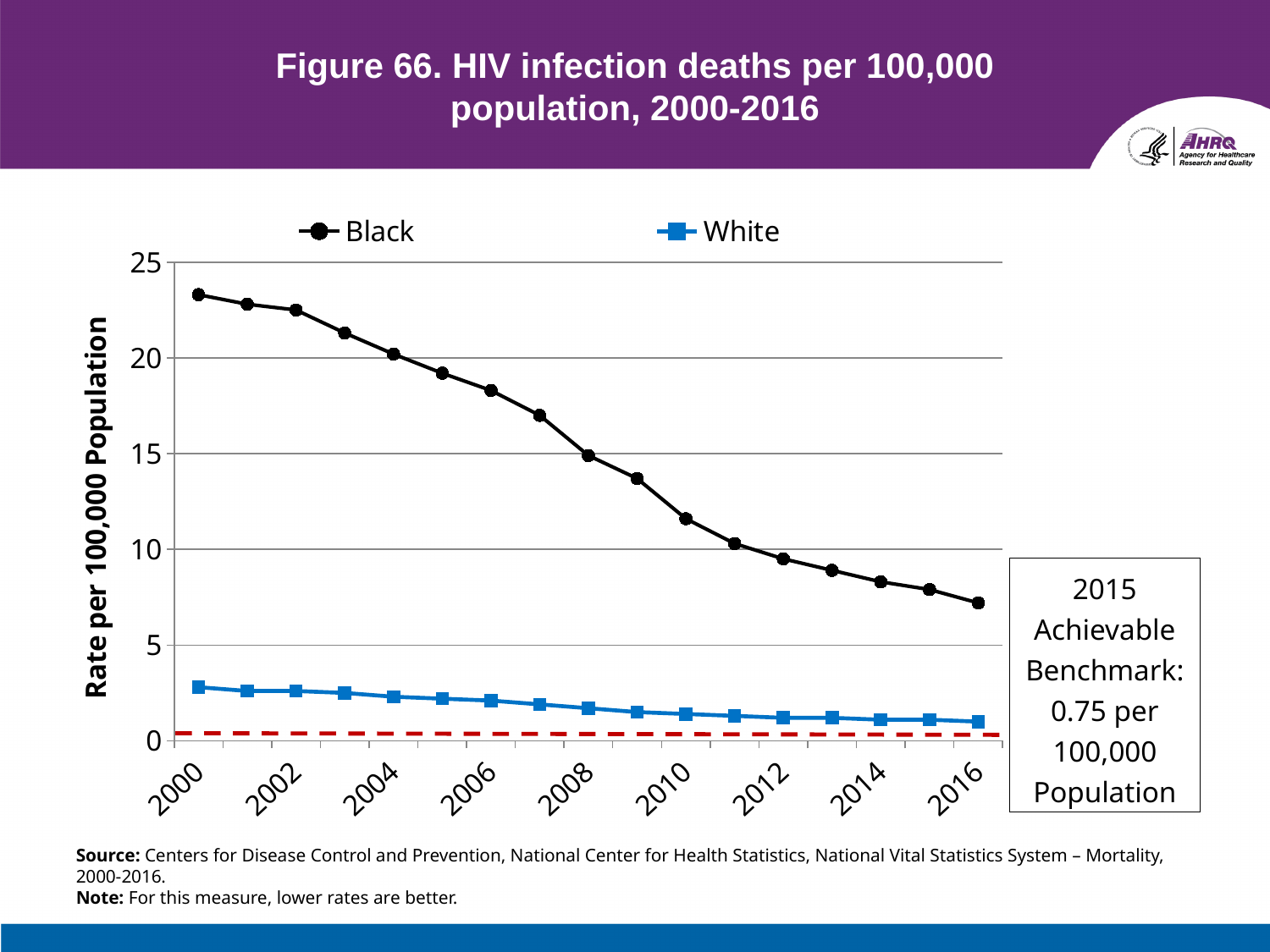
How many series does the legend list? 2 In which year is the Black series at its highest? 2000 What kind of chart is shown on the slide? Line chart In 2016, which series has the higher rate, Black or White? Black Which two series are listed in the legend? Black and White Is the value for Black in 2000 greater or less than 20? greater Does the Black series rise or fall from 2000 to 2016? Fall What is the 2015 Achievable Benchmark stated on the slide? 0.75 per 100,000 Population Is the value for Black in 2016 greater or less than 10? less Is the value for White in 2000 greater or less than 5? less In which year is the Black series at its lowest? 2016